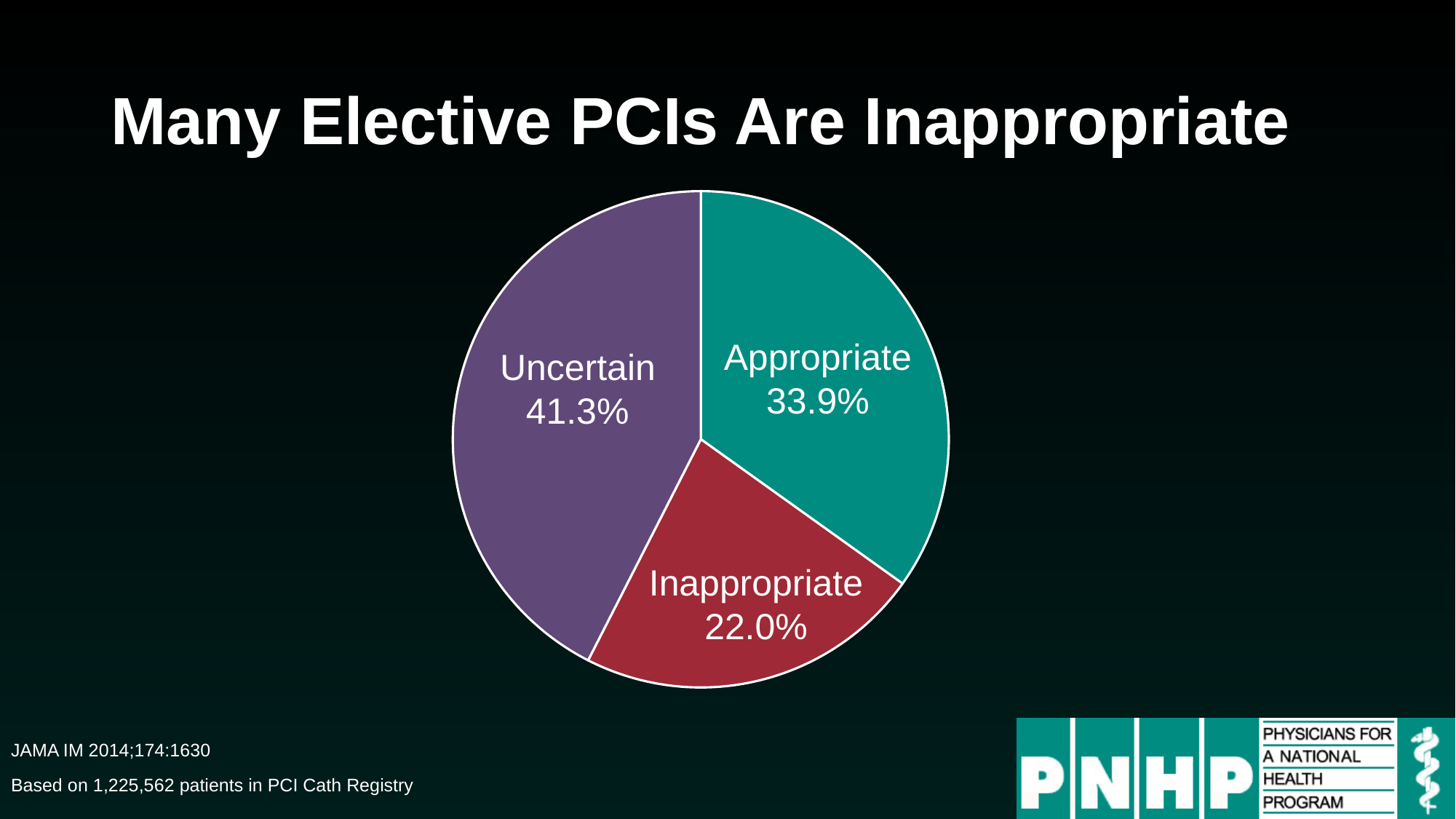
How many slices does the pie chart have? 3 What percentage of elective PCIs are labelled Appropriate? 33.9% What percentage of elective PCIs are labelled Uncertain? 41.3% Which category has the largest share of the pie? Uncertain What percentage of elective PCIs are labelled Inappropriate? 22.0% What colour is the Inappropriate slice of the pie chart? red Which is larger, the Appropriate slice or the Inappropriate slice? Appropriate What is the difference in percentage points between the Appropriate and Inappropriate slices? 11.9 Which category has the smallest share of the pie? Inappropriate What is the title of the slide containing the pie chart? Many Elective PCIs Are Inappropriate What is the difference in percentage points between the Uncertain and Appropriate slices? 7.4 What kind of chart is shown on the slide? pie chart